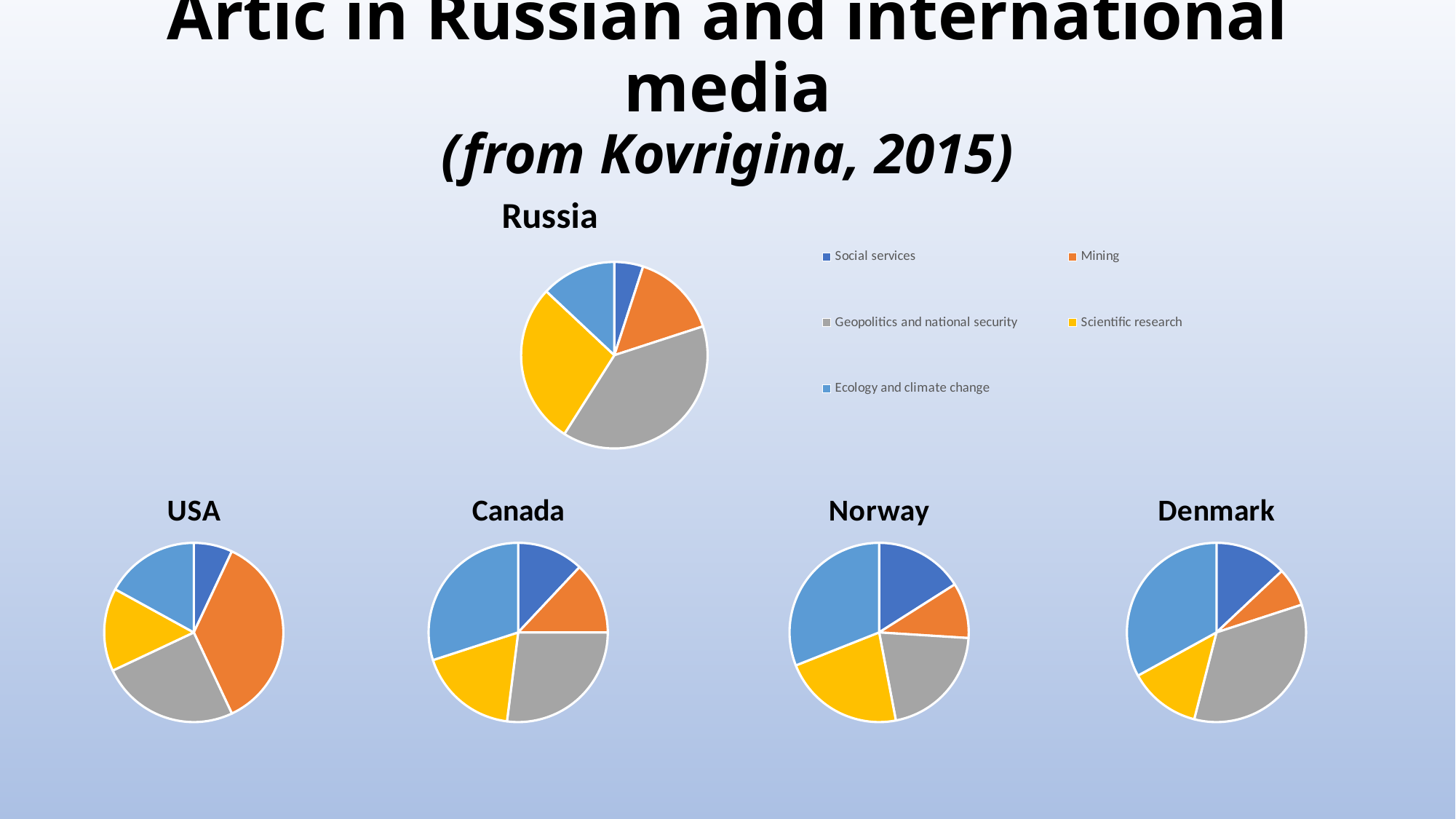
In the Norway pie chart, which category has the largest slice? Ecology and climate change In the USA pie chart, which category has the largest slice? Mining How many pie charts are shown on the slide? 5 Which colour represents Scientific research in the legend? Yellow In the Denmark pie chart, which category has the smallest slice? Mining In the Russia pie chart, which category has the smallest slice? Social services What kind of chart is used to show the Russia data? Pie chart In the USA pie chart, which category has the smallest slice? Social services In the Russia pie chart, which category has the largest slice? Geopolitics and national security In the Russia pie chart, which slice is larger: Scientific research or Mining? Scientific research How many categories does the legend list? 5